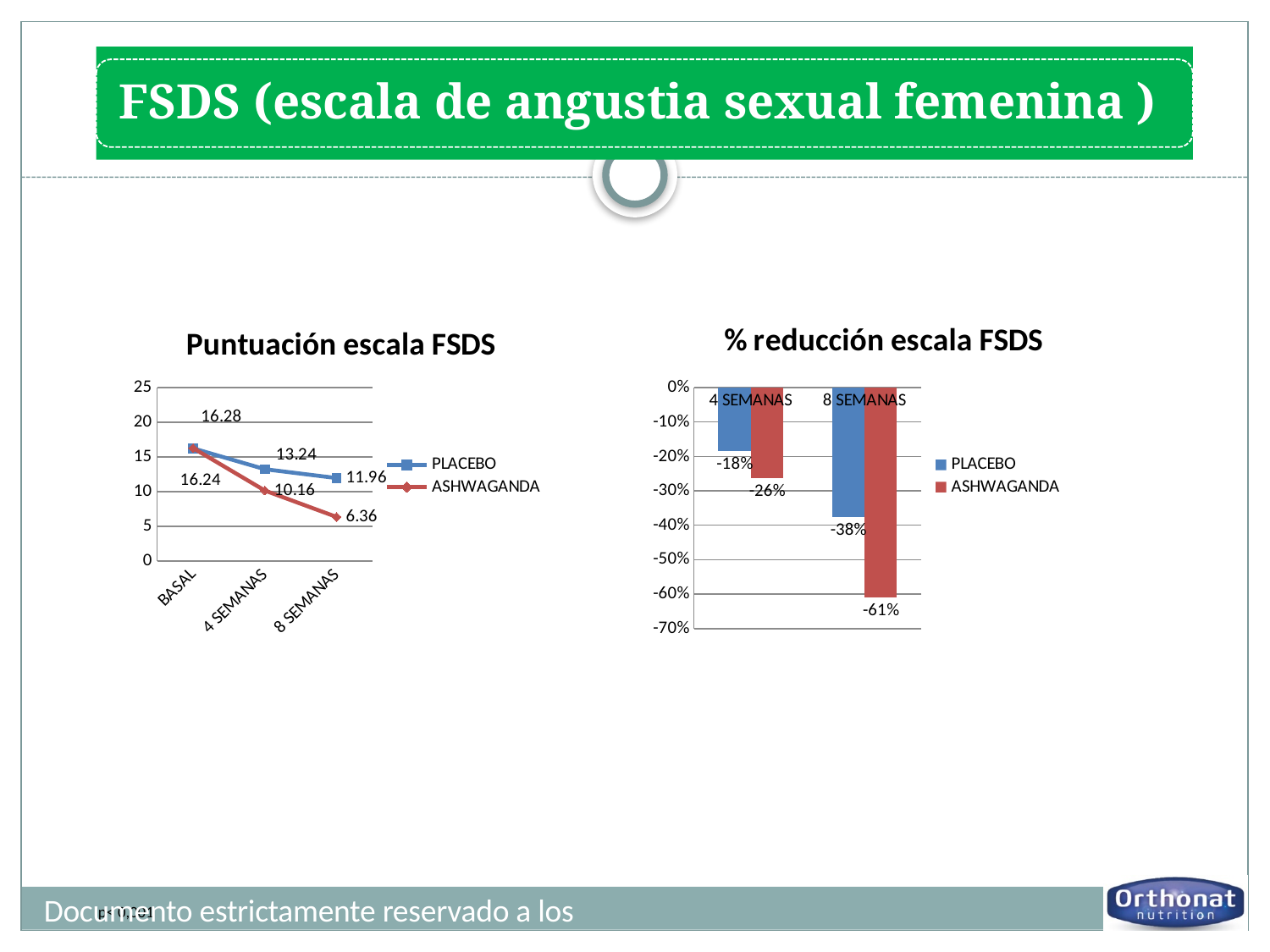
In the 'Puntuación escala FSDS' chart, does the ASHWAGANDA series rise or fall from BASAL to 8 SEMANAS? fall In the '% reducción escala FSDS' chart, what is the PLACEBO value at 4 SEMANAS? -18% In the 'Puntuación escala FSDS' chart, what is the ASHWAGANDA value at 8 SEMANAS? 6.36 In the '% reducción escala FSDS' chart, how many categories are shown on the x axis? 2 In the 'Puntuación escala FSDS' chart, how many series does the legend list? 2 What kind of chart is '% reducción escala FSDS'? bar chart In the 'Puntuación escala FSDS' chart, what is the ASHWAGANDA value at 4 SEMANAS? 10.16 In the '% reducción escala FSDS' chart, what is the ASHWAGANDA value at 8 SEMANAS? -61% In the 'Puntuación escala FSDS' chart, what is the difference between the PLACEBO and ASHWAGANDA values at 8 SEMANAS? 5.6 What kind of chart is 'Puntuación escala FSDS'? line chart In the '% reducción escala FSDS' chart, which series shows the larger reduction at 8 SEMANAS? ASHWAGANDA In the 'Puntuación escala FSDS' chart, what is the PLACEBO value at 8 SEMANAS? 11.96